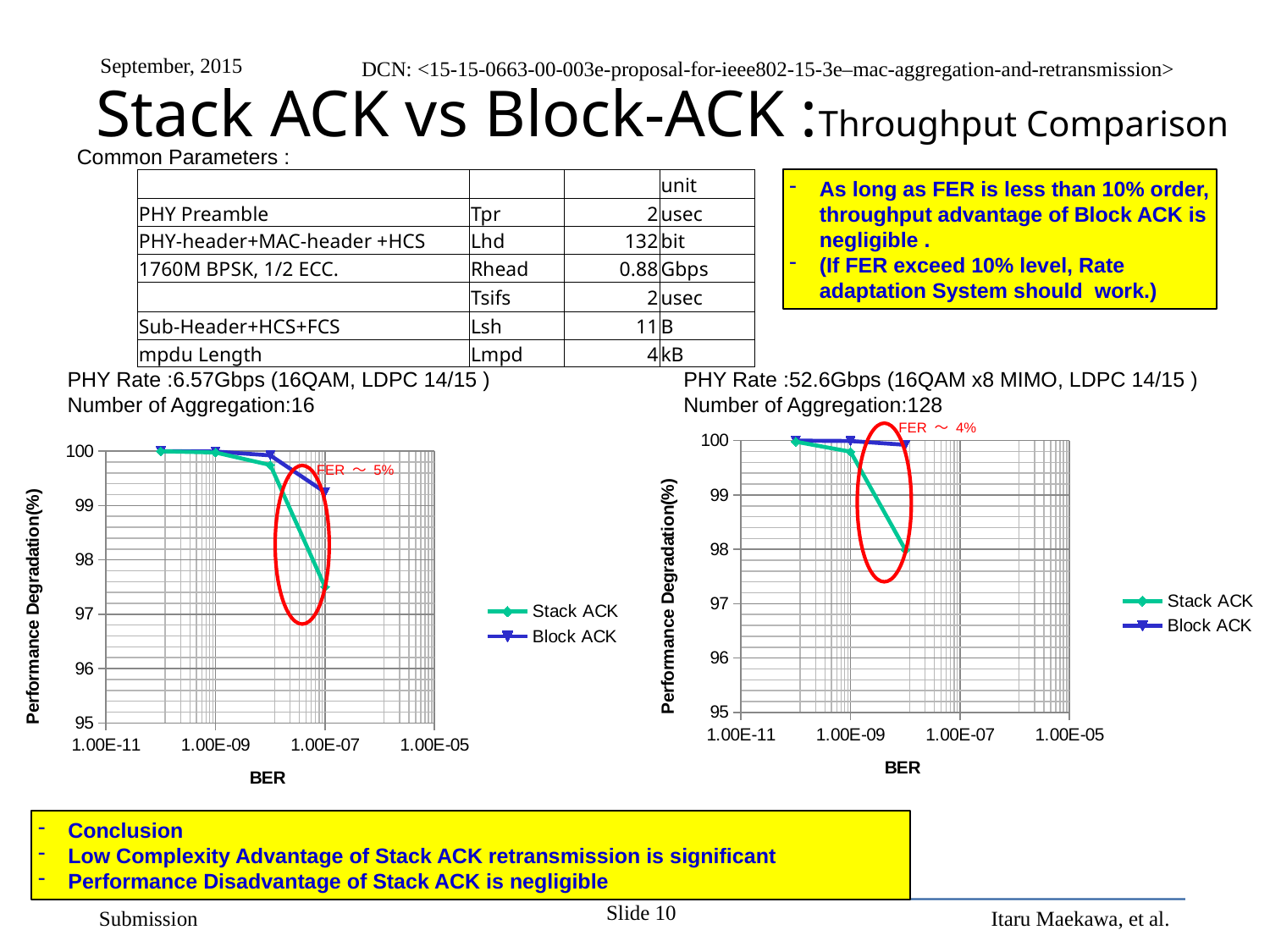
On the left chart (Number of Aggregation:16), does the Block ACK series rise or fall as BER increases along the x axis? Fall On the left chart (Number of Aggregation:16), is the Stack ACK value at BER 1.00E-07 greater or less than 98? less On the right chart (Number of Aggregation:128), does the Stack ACK series rise or fall as BER increases along the x axis? Fall On the left chart (Number of Aggregation:16), is the Block ACK value at BER 1.00E-07 greater or less than 99? greater How many data points are plotted for the Stack ACK series on the left chart (Number of Aggregation:16)? 4 On the right chart (Number of Aggregation:128), is the Block ACK value at BER 1.00E-08 greater or less than 99? greater On the right chart (Number of Aggregation:128), which series has the higher value at BER 1.00E-08, Stack ACK or Block ACK? Block ACK How many series does the legend of the right chart (PHY Rate 52.6Gbps, Number of Aggregation:128) list? 2 What is the label of the x axis on the left chart (Number of Aggregation:16)? BER What kind of chart is the left chart (PHY Rate 6.57Gbps, Number of Aggregation:16)? Line chart What are the two series named in the legend of the left chart (Number of Aggregation:16)? Stack ACK and Block ACK On the left chart (Number of Aggregation:16), which series has the higher value at BER 1.00E-07, Stack ACK or Block ACK? Block ACK